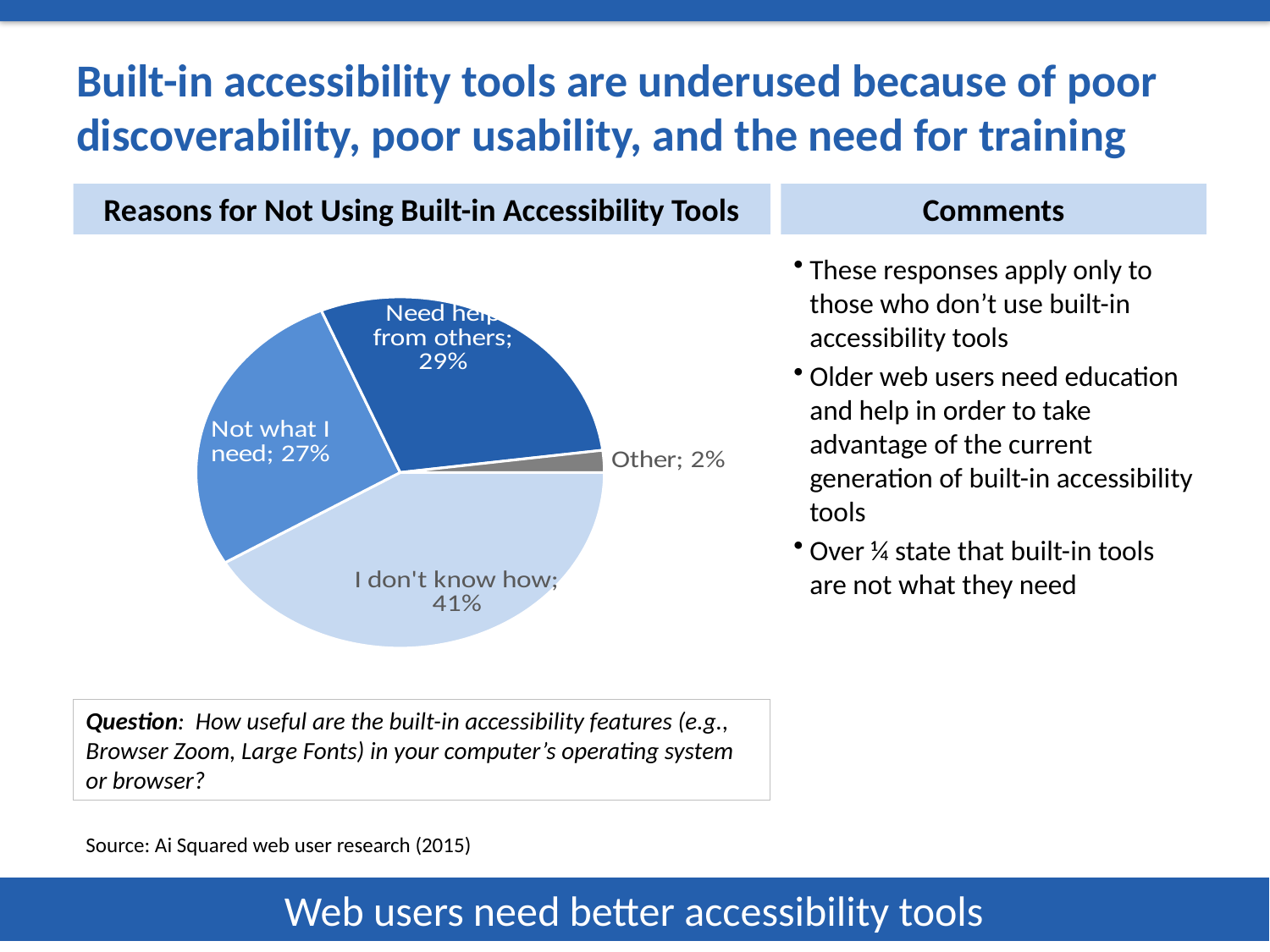
How many slices does the pie chart have? 4 What is the difference in percentage points between 'Need help from others' and 'Other'? 27 What share of the pie is 'Need help from others'? 29% What share of the pie is 'Not what I need'? 27% What share of the pie is 'I don't know how'? 41% Which slice of the pie is the largest? I don't know how What kind of chart is shown on the slide? pie chart Which is larger, 'Need help from others' or 'Not what I need'? Need help from others Which slice of the pie is the smallest? Other What is the title of the chart? Reasons for Not Using Built-in Accessibility Tools What is the difference in percentage points between 'I don't know how' and 'Not what I need'? 14